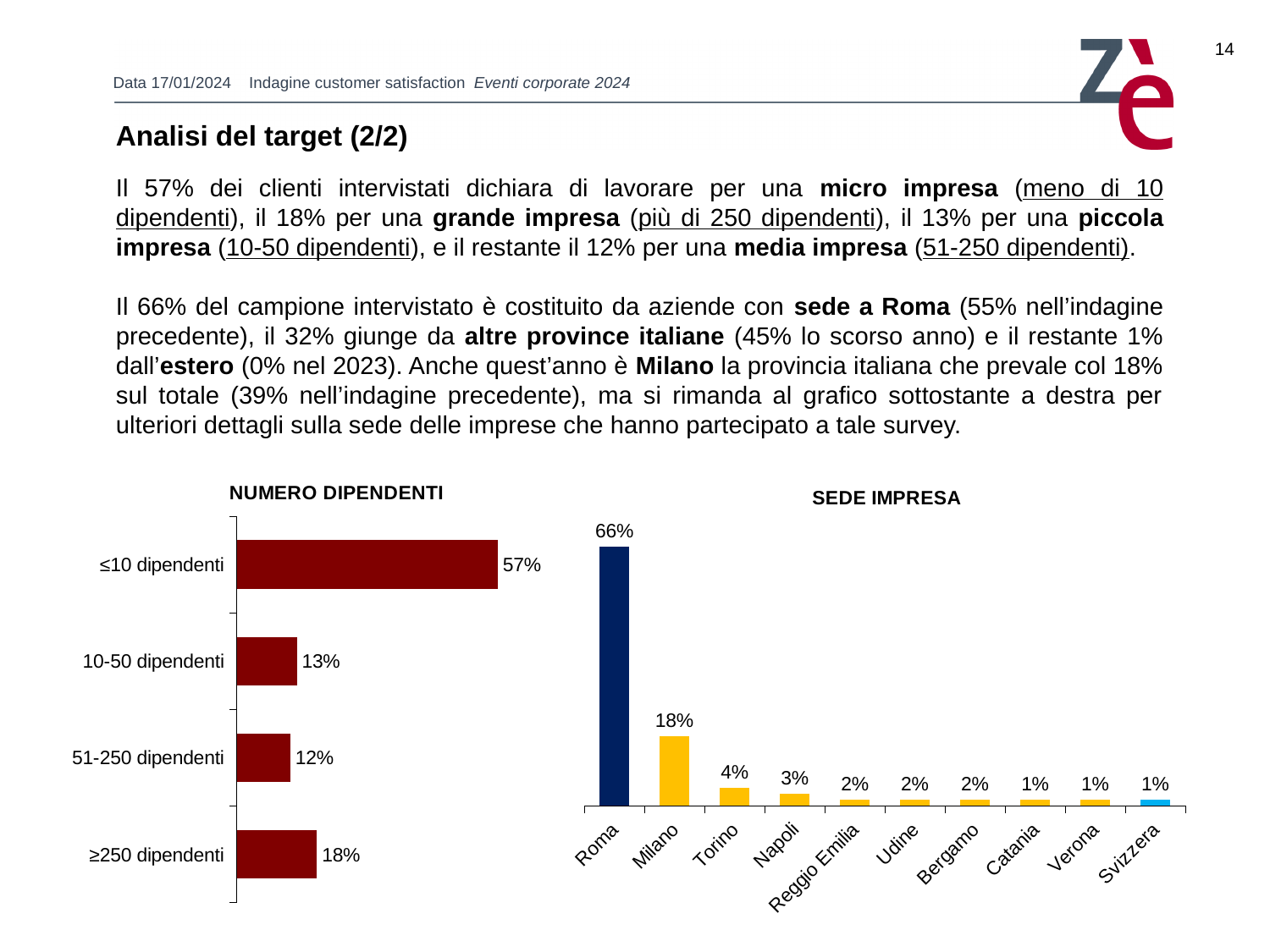
In the NUMERO DIPENDENTI chart, what is the difference between the values for ≤10 dipendenti and ≥250 dipendenti? 39% In the SEDE IMPRESA chart, what is the value for Milano? 18% In the NUMERO DIPENDENTI chart, which category has the lowest value? 51-250 dipendenti In the SEDE IMPRESA chart, what is the difference between the values for Roma and Milano? 48% What kind of chart is the NUMERO DIPENDENTI chart? Bar chart In the SEDE IMPRESA chart, how many categories are shown? 10 In the NUMERO DIPENDENTI chart, what is the value for ≥250 dipendenti? 18% In the SEDE IMPRESA chart, what is the value for Napoli? 3% In the NUMERO DIPENDENTI chart, how many categories are shown? 4 In the SEDE IMPRESA chart, which is larger, the value for Torino or the value for Udine? Torino In the SEDE IMPRESA chart, which category has the highest value? Roma In the NUMERO DIPENDENTI chart, what is the value for ≤10 dipendenti? 57%